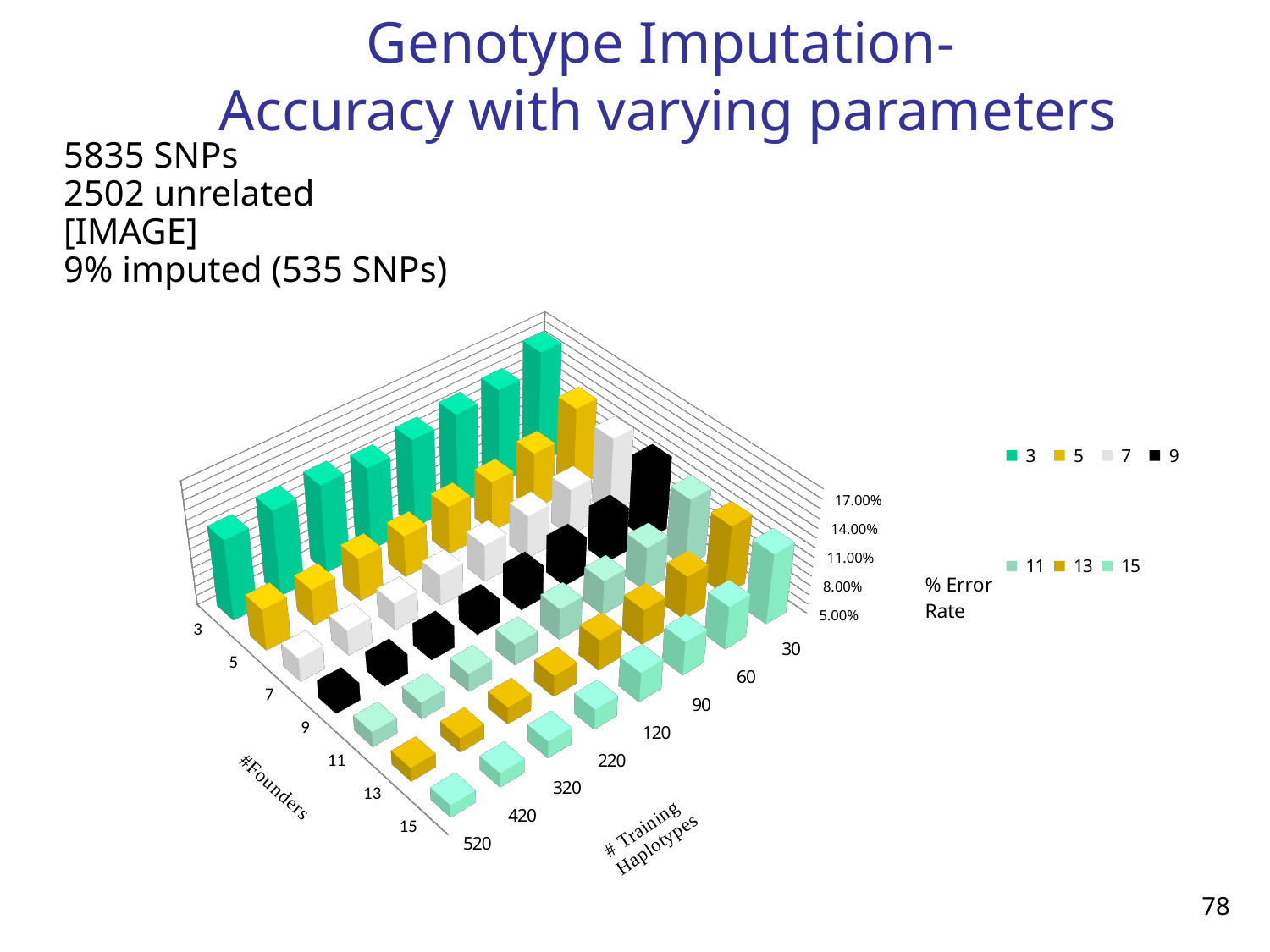
What is the highest tick value shown on the % Error Rate axis? 17.00% For the 3-founders series, do the bars rise or fall as the number of training haplotypes goes from 520 down to 30? rise How many series does the chart's legend list? 7 Which series has higher error rates overall, 3 founders or 15 founders? 3 Which series (number of founders) has the tallest bars in the chart? 3 What kind of chart is shown on the slide? 3D bar chart How many #Founders values are shown on the chart's axis? 7 How many # Training Haplotypes categories are shown along the chart's axis? 8 What is the label of the chart's vertical value axis? % Error Rate Which series has higher bars, 3 founders or 9 founders? 3